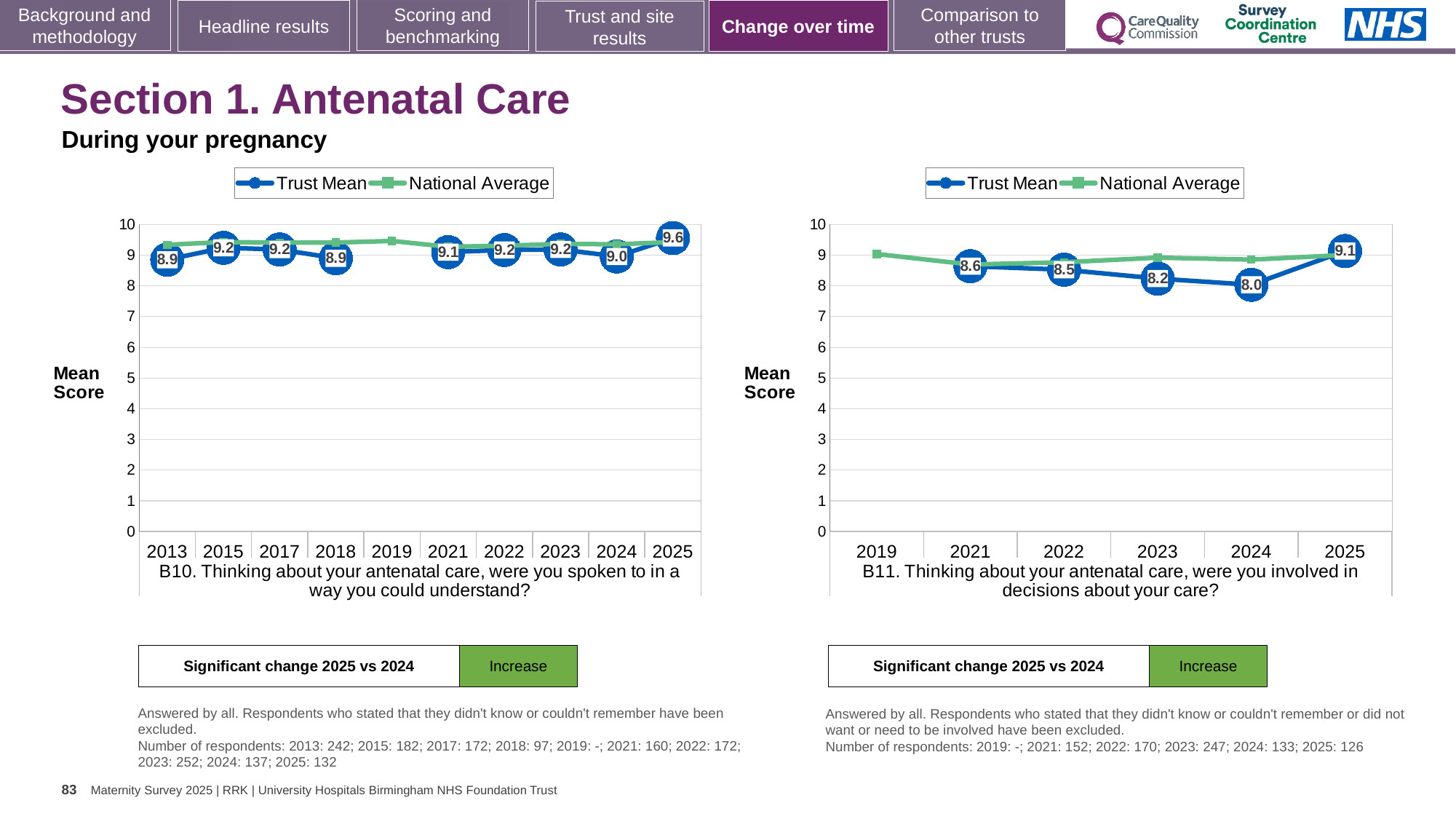
In the B11 chart (right), which year has the lowest Trust Mean score? 2024 In the B11 chart (right), which is larger, the Trust Mean score for 2021 or for 2023? 2021 In the B11 chart (right), what is the Trust Mean score for 2024? 8.0 How many years are shown on the x axis of the B11 chart (right)? 6 How many series does the legend of the B10 chart (left) list? 2 In the B10 chart (left), what is the Trust Mean score for 2013? 8.9 In the B10 chart (left), which year has the highest Trust Mean score? 2025 In the B10 chart (left), what is the Trust Mean score for 2025? 9.6 In the B11 chart (right), is the National Average for 2019 greater or less than 8? greater In the B11 chart (right), what is the difference between the Trust Mean scores for 2025 and 2024? 1.1 In the B10 chart (left), what is the difference between the Trust Mean scores for 2025 and 2024? 0.6 What kind of chart is the B10 chart (left)? Line chart